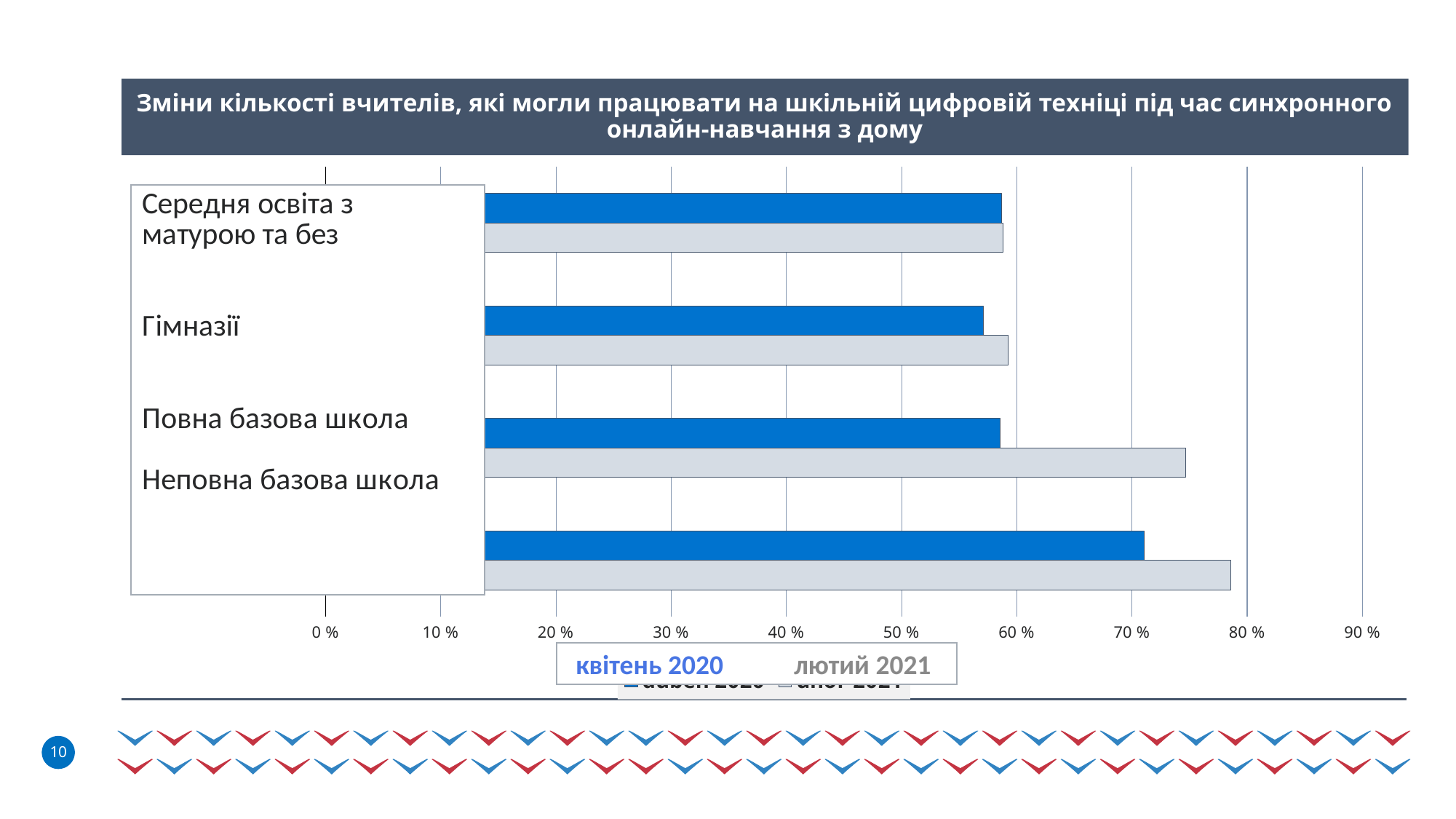
Which category has the highest value for квітень 2020? Неповна базова школа What kind of chart is shown on the slide? bar chart Which two series are shown in the legend? квітень 2020 and лютий 2021 How many series does the legend list? 2 How many categories are plotted on the chart? 4 Is the лютий 2021 value for Повна базова школа greater or less than 70 %? greater Is the лютий 2021 value for Неповна базова школа greater or less than 70 %? greater For Повна базова школа, which series has the larger value: квітень 2020 or лютий 2021? лютий 2021 For Неповна базова школа, which series has the larger value: квітень 2020 or лютий 2021? лютий 2021 Which category has the highest value for лютий 2021? Неповна базова школа Is the квітень 2020 value for Гімназії greater or less than 60 %? less